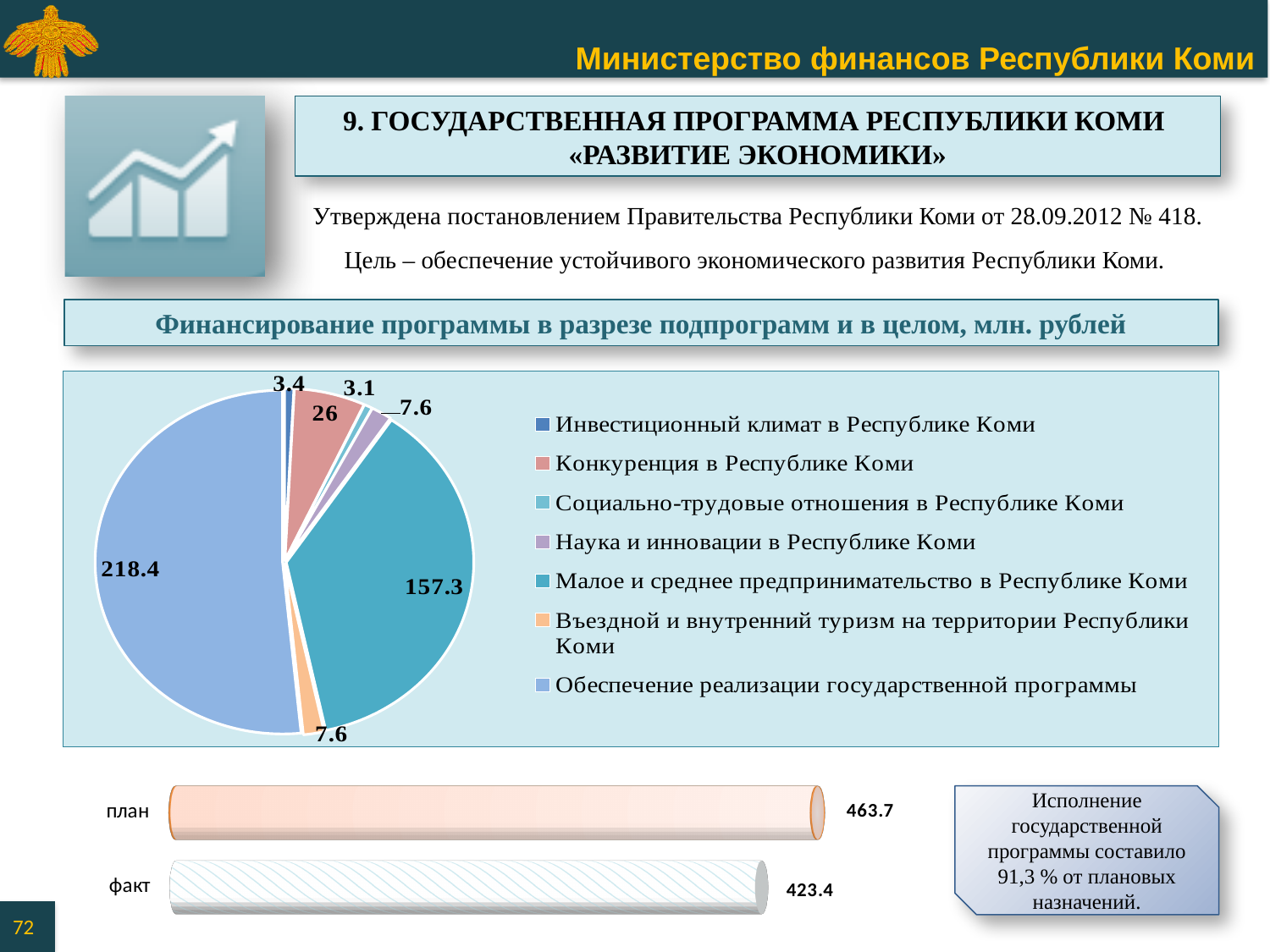
In the pie chart, which is larger: Конкуренция в Республике Коми or Наука и инновации в Республике Коми? Конкуренция в Республике Коми In the pie chart, what is the value for Конкуренция в Республике Коми? 26 In the pie chart, what is the value for Обеспечение реализации государственной программы? 218.4 In the pie chart, what is the value for Инвестиционный климат в Республике Коми? 3.4 In the bar chart at the bottom of the slide, what is the difference between план and факт? 40.3 In the pie chart, which category has the largest slice? Обеспечение реализации государственной программы In the bar chart at the bottom of the slide, what is the value for план? 463.7 How many categories does the pie chart's legend list? 7 In the pie chart, what is the value for Малое и среднее предпринимательство в Республике Коми? 157.3 What kind of chart is the chart at the bottom of the slide showing план and факт? bar chart In the pie chart, which category has the smallest slice? Социально-трудовые отношения в Республике Коми In the pie chart, what is the difference between the values for Обеспечение реализации государственной программы and Малое и среднее предпринимательство в Республике Коми? 61.1